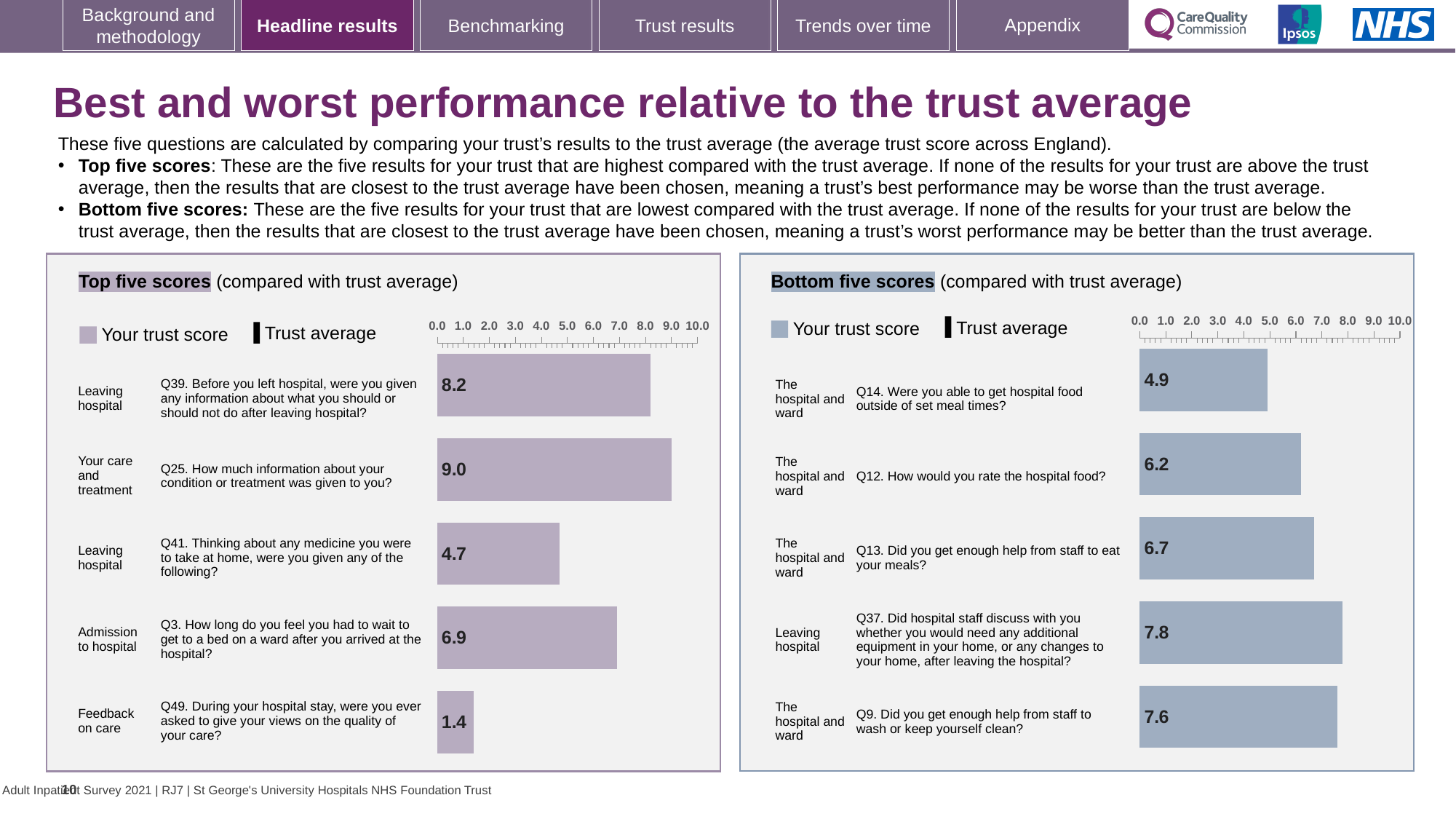
In the Bottom five scores chart, which has the larger trust score: Q13 or Q9? Q9 In the Bottom five scores chart, what is the trust score for Q37 (did hospital staff discuss whether you would need additional equipment or changes at home)? 7.8 What type of chart is used for the Top five scores? Bar chart How many series does the legend of the Top five scores chart list? 2 In the Top five scores chart, what is the trust score for Q25 (how much information about your condition or treatment was given to you)? 9.0 In the Top five scores chart, what is the trust score for Q49 (were you ever asked to give your views on the quality of your care)? 1.4 In the Bottom five scores chart, which question has the lowest trust score? Q14 In the Top five scores chart, what is the difference between the trust scores for Q39 and Q41? 3.5 How many questions are shown in the Bottom five scores chart? 5 In the Top five scores chart, which question has the highest trust score? Q25 In the Bottom five scores chart, is the trust score for Q14 greater or less than 5.0? less In the Bottom five scores chart, what is the trust score for Q12 (how would you rate the hospital food)? 6.2